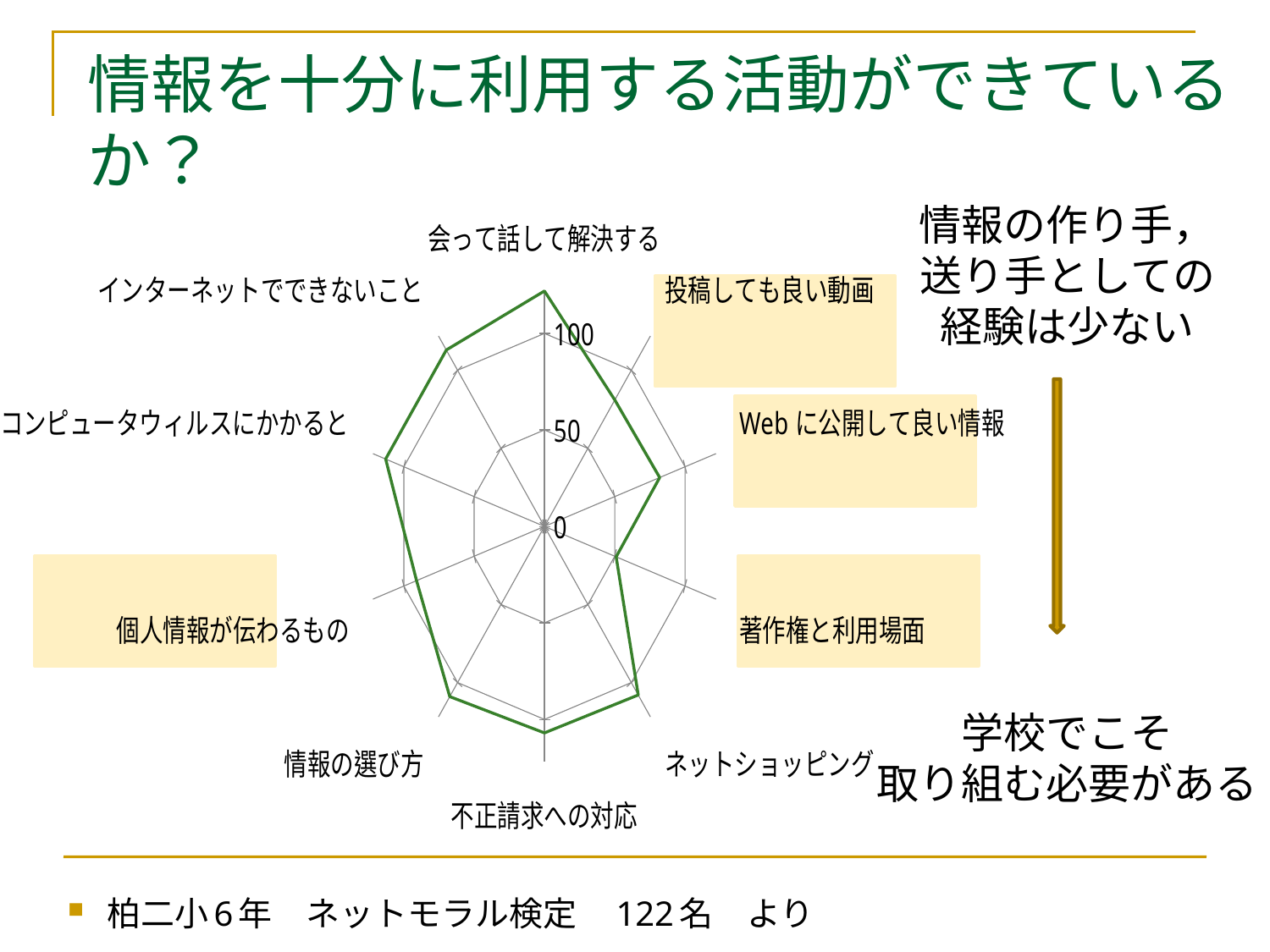
Which is larger, the value for ネットショッピング or the value for 著作権と利用場面? ネットショッピング Is the value for ネットショッピング greater or less than 50? greater What kind of chart is shown on the slide? radar chart Which is larger, the value for 会って話して解決する or the value for Webに公開して良い情報? 会って話して解決する How many categories (axes) does the radar chart have? 10 What category label appears at the top of the radar chart? 会って話して解決する Which category has the lowest value on the radar chart? 著作権と利用場面 Is the value for コンピュータウィルスにかかると greater or less than 50? greater Is the value for インターネットでできないこと greater or less than 50? greater What is the maximum value shown on the radar chart's axis scale? 100